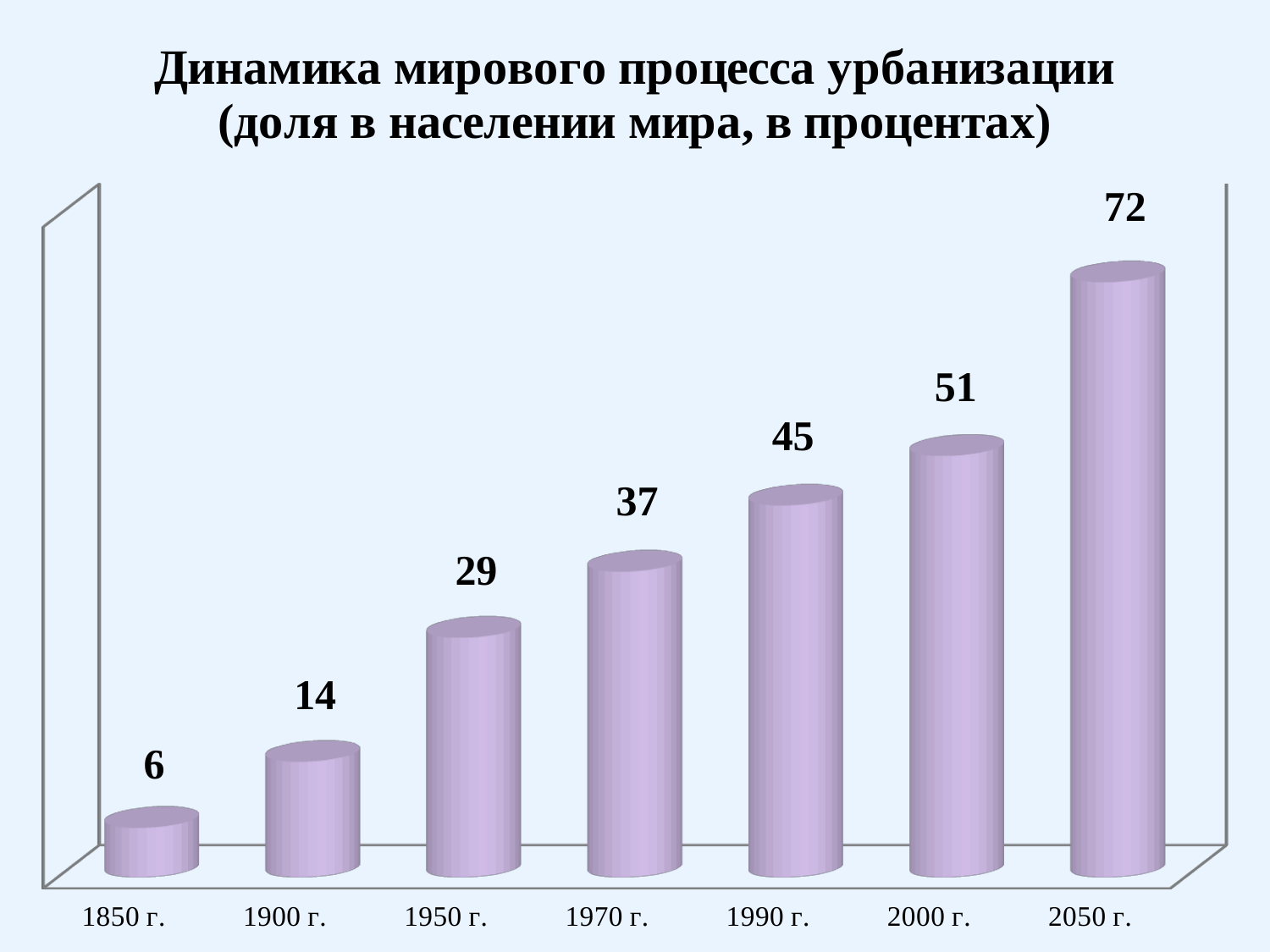
Which is larger, the value for 1990 г. or the value for 1970 г.? 1990 г. Which year has the highest value? 2050 г. Which year has the lowest value? 1850 г. What is the value for 1850 г.? 6 What kind of chart is this? bar chart What is the value for 1950 г.? 29 Do the values rise or fall from 1850 г. to 2050 г.? rise What is the difference between the values for 1970 г. and 1900 г.? 23 What is the title of the chart? Динамика мирового процесса урбанизации (доля в населении мира, в процентах) How many years are shown on the x axis? 7 What is the value for 2000 г.? 51 What is the difference between the values for 2050 г. and 2000 г.? 21